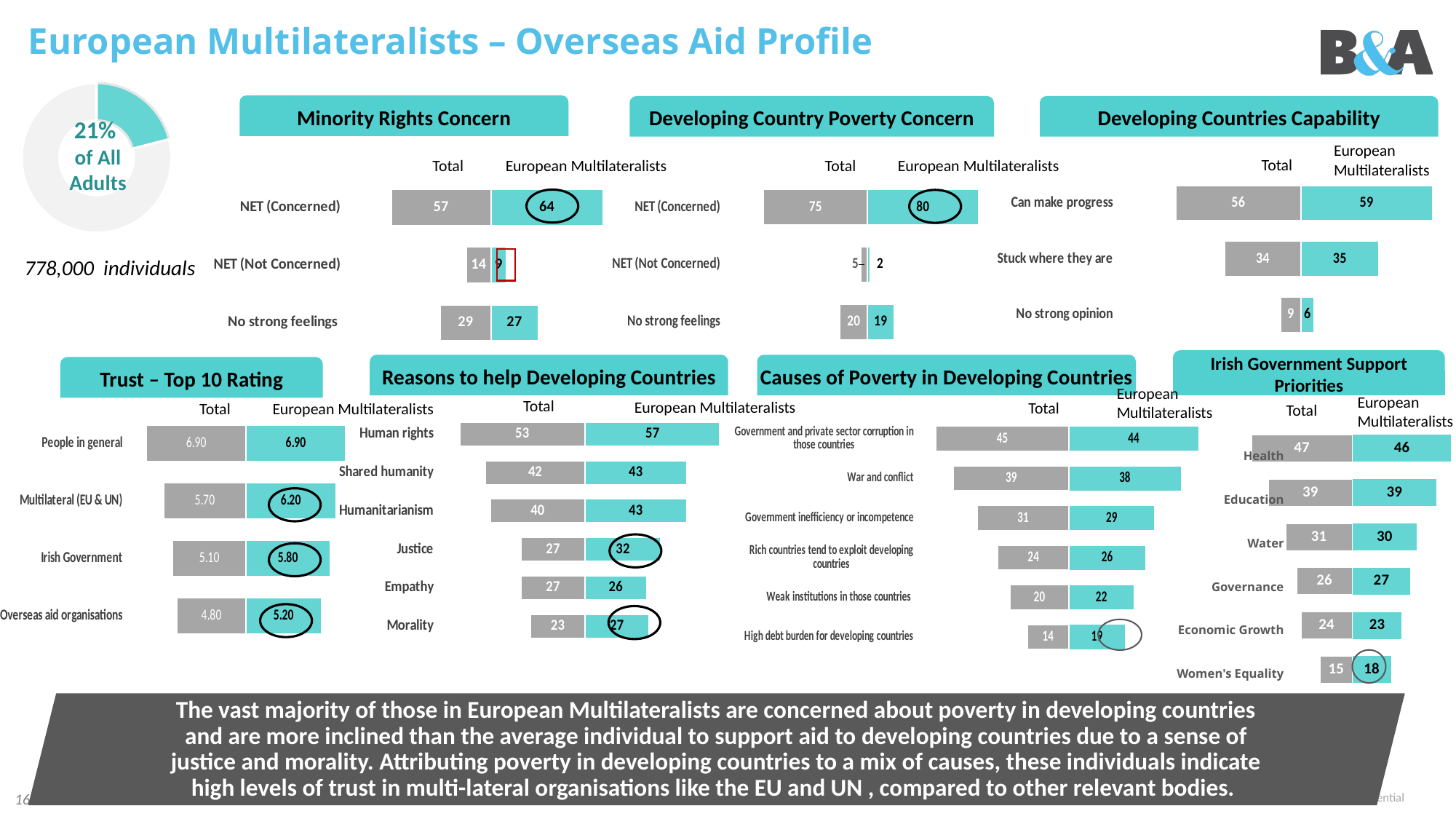
In the 'Reasons to help Developing Countries' chart, how many reasons are listed? 6 In the 'Causes of Poverty in Developing Countries' chart, what is the Total value for War and conflict? 39 In the 'Developing Countries Capability' chart, which category has the highest European Multilateralists value? Can make progress In the 'Developing Country Poverty Concern' chart, what is the difference between the European Multilateralists and Total values for NET (Concerned)? 5 In the 'Trust – Top 10 Rating' chart, what is the European Multilateralists rating for Multilateral (EU & UN)? 6.20 In the 'Irish Government Support Priorities' chart, what is the European Multilateralists value for Women's Equality? 18 What share of all adults does the donut chart on the left show for European Multilateralists? 21% In the 'Minority Rights Concern' chart, what is the European Multilateralists value for NET (Concerned)? 64 In the 'Causes of Poverty in Developing Countries' chart, which cause has the lowest Total value? High debt burden for developing countries In the 'Reasons to help Developing Countries' chart, is the European Multilateralists value for Justice larger or smaller than the Total value? larger In the 'Developing Country Poverty Concern' chart, what is the Total value for NET (Concerned)? 75 In the 'Trust – Top 10 Rating' chart, which category has the lowest Total rating? Overseas aid organisations